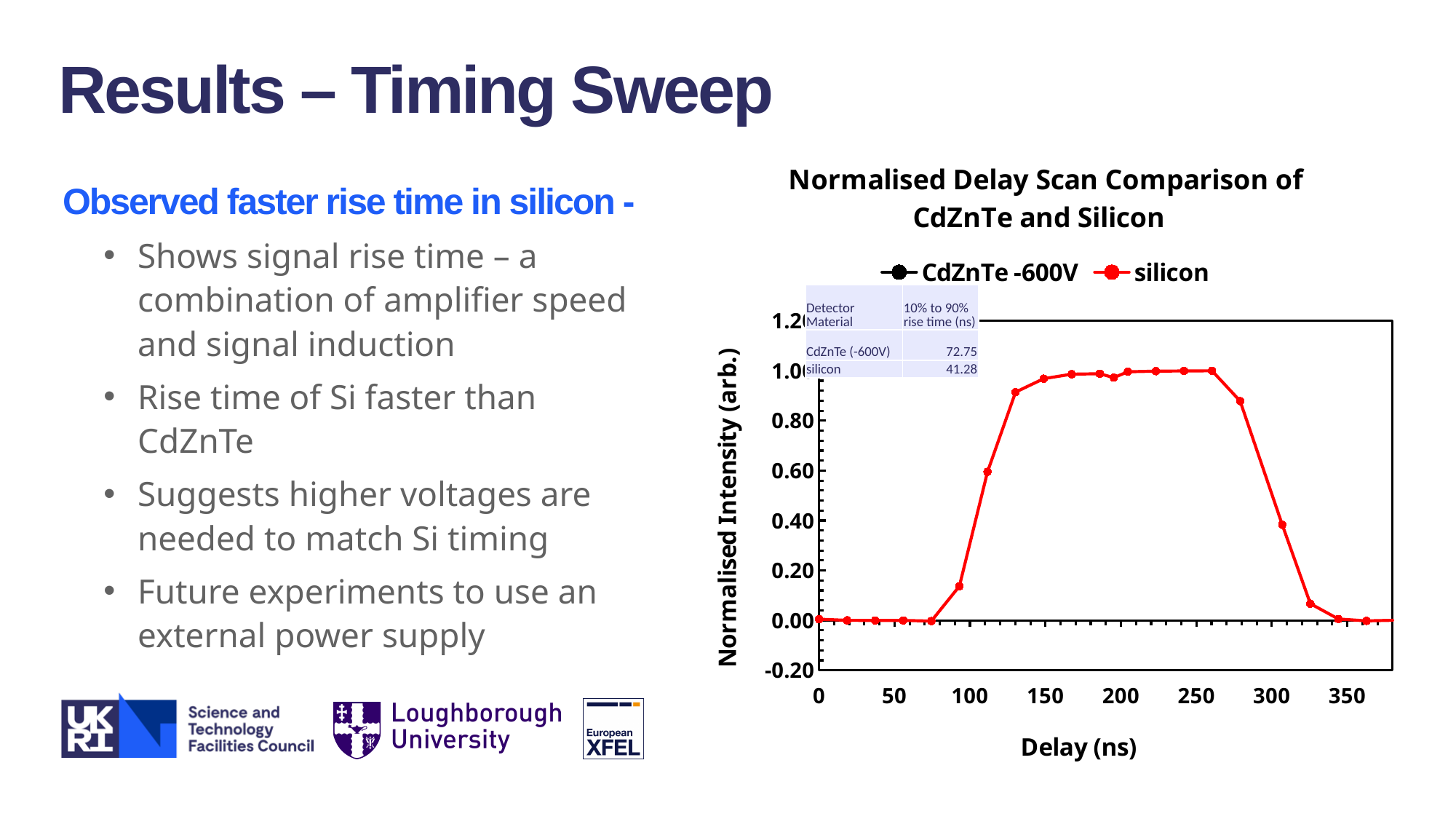
According to the table inset in the chart, what is the 10% to 90% rise time (ns) for silicon? 41.28 Which detector material has the longer 10% to 90% rise time in the inset table, CdZnTe (-600V) or silicon? CdZnTe (-600V) What kind of chart is shown on the slide? line chart What is the difference between the 10% to 90% rise times of CdZnTe (-600V) and silicon in the inset table? 31.47 Is the silicon normalised intensity at a delay of 50 ns greater or less than 0.20? less Does the silicon normalised intensity rise or fall as the delay increases from 250 ns to 350 ns? fall How many series does the legend of the chart list? 2 What is the label of the x axis of the chart? Delay (ns) Is the silicon normalised intensity at a delay of 200 ns greater or less than 0.80? greater According to the table inset in the chart, what is the 10% to 90% rise time (ns) for CdZnTe (-600V)? 72.75 What is the title of the chart? Normalised Delay Scan Comparison of CdZnTe and Silicon